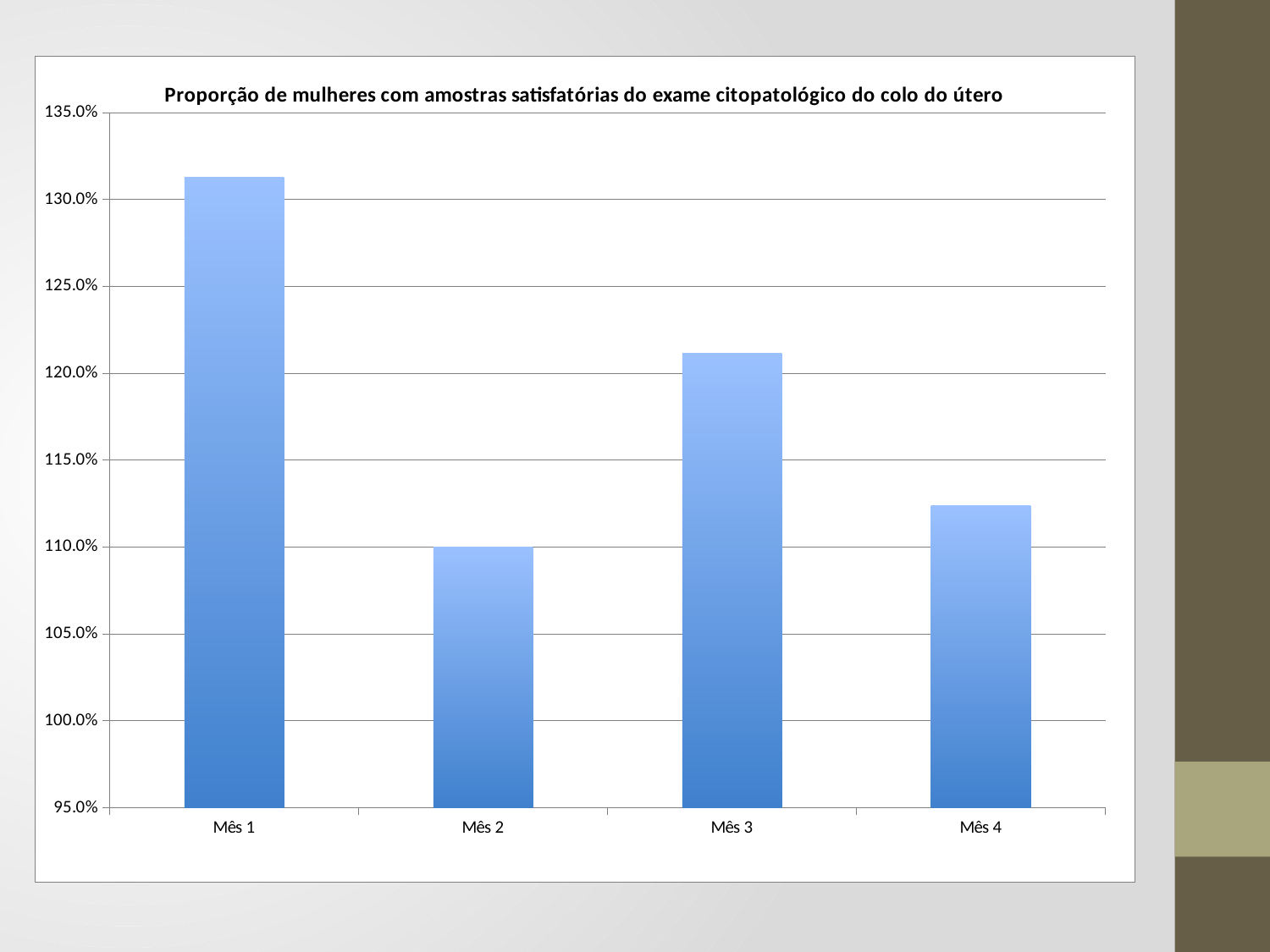
Which is larger, the value for Mês 3 or the value for Mês 4? Mês 3 How many categories (months) are shown on the x axis? 4 Which month has the highest value? Mês 1 Does the value rise or fall from Mês 1 to Mês 2? fall What is the title of the chart? Proporção de mulheres com amostras satisfatórias do exame citopatológico do colo do útero Is the value for Mês 3 greater or less than 120.0%? greater What kind of chart is shown on the slide? bar chart What is the value for Mês 2? 110.0% Is the value for Mês 1 greater or less than 130.0%? greater Is the value for Mês 4 greater or less than 115.0%? less Which month has the lowest value? Mês 2 Which is larger, the value for Mês 1 or the value for Mês 3? Mês 1